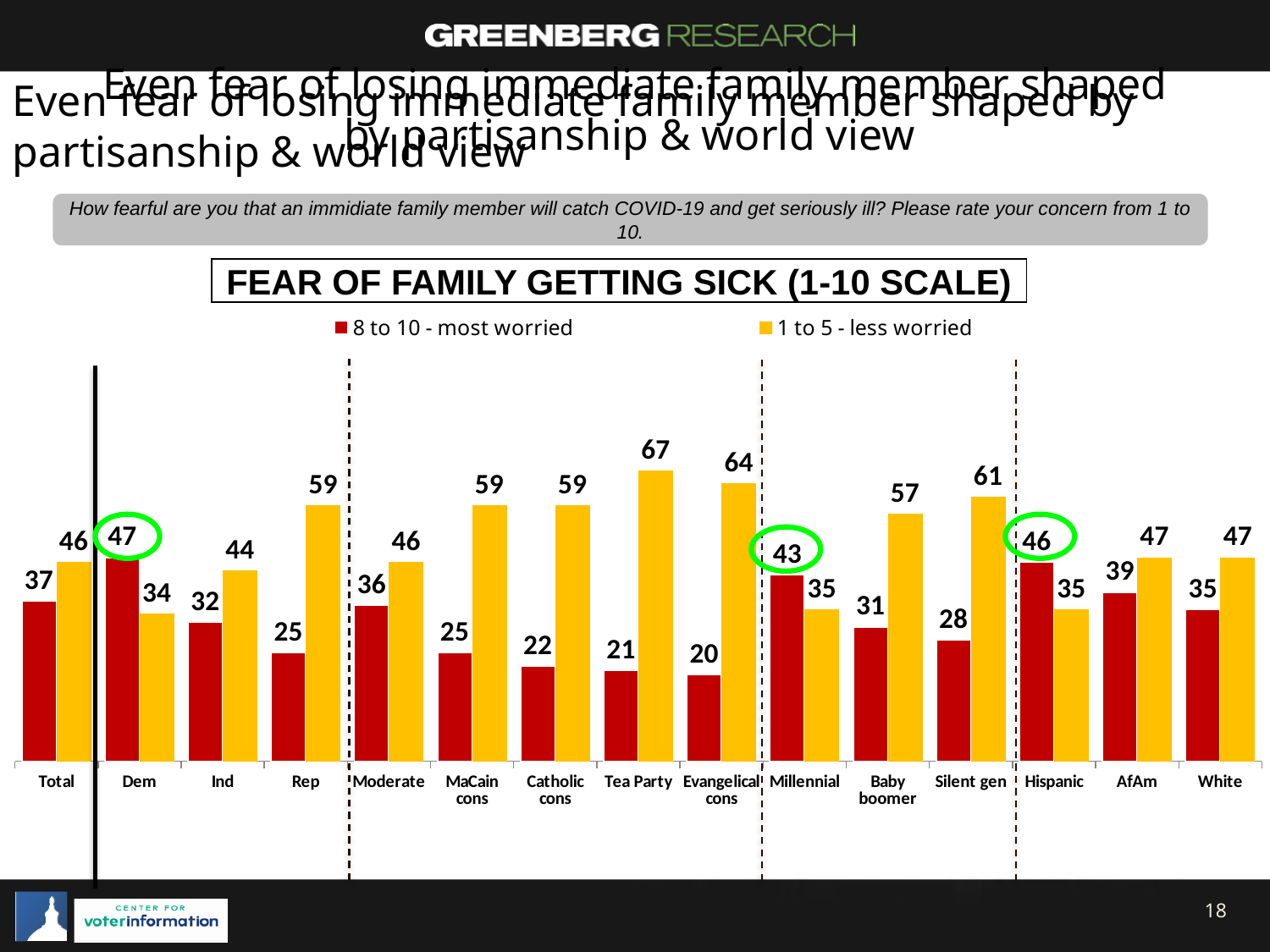
Which category has the highest '1 to 5 - less worried' value? Tea Party Which is larger for Hispanic: the '8 to 10 - most worried' value or the '1 to 5 - less worried' value? 8 to 10 - most worried What is the '8 to 10 - most worried' value for Millennial? 43 Which category has the lowest '1 to 5 - less worried' value? Dem How many categories are shown on the x axis? 15 What is the title of the chart? FEAR OF FAMILY GETTING SICK (1-10 SCALE) What is the value for Tea Party in the '1 to 5 - less worried' series? 67 How many series does the legend list? 2 What is the difference between the '1 to 5 - less worried' and '8 to 10 - most worried' values for Rep? 34 What is the value for Dem in the '8 to 10 - most worried' series? 47 What kind of chart is shown on the slide? Bar chart Which category has the lowest '8 to 10 - most worried' value? Evangelical cons